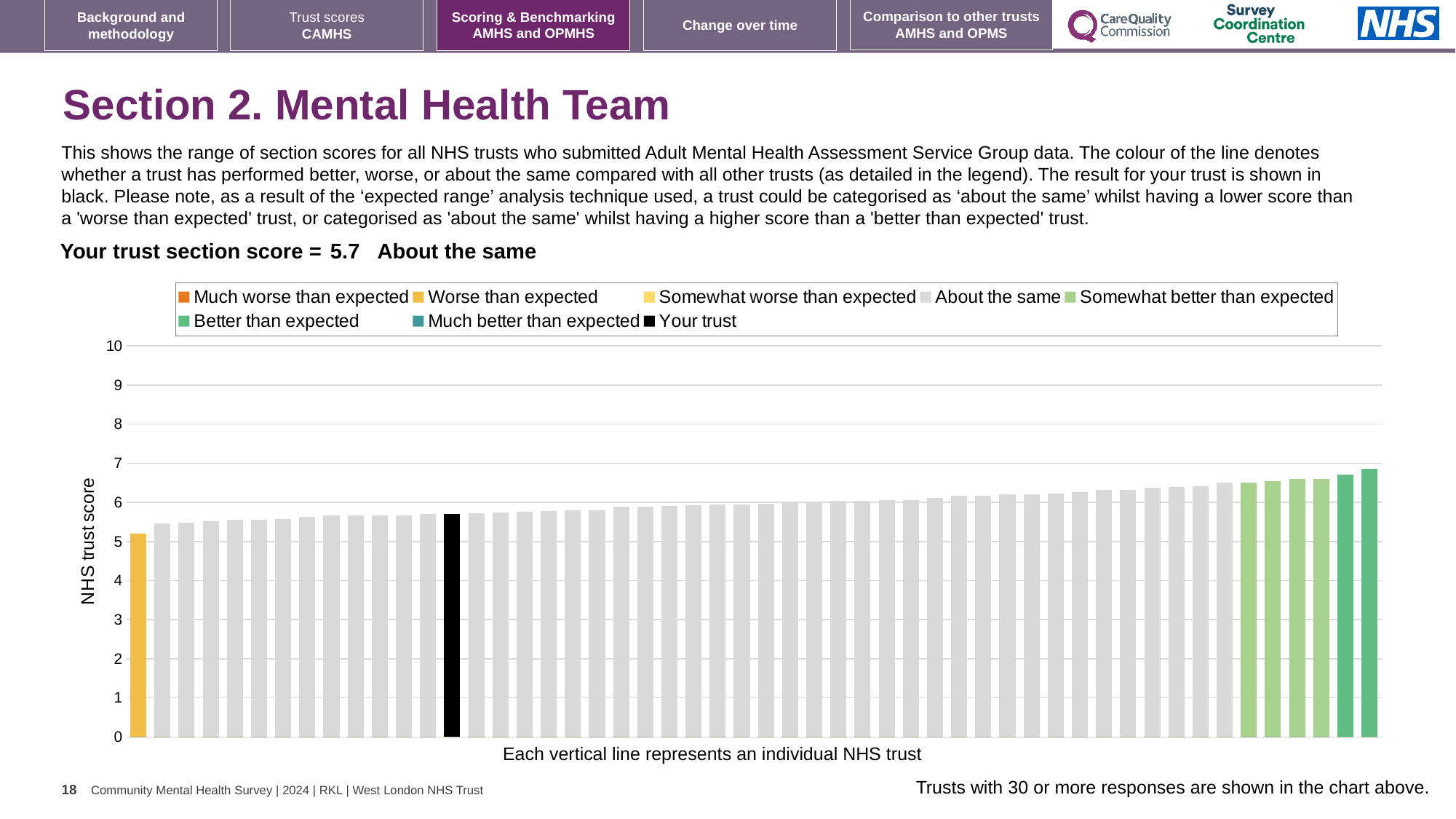
Is the value of the black 'Your trust' bar greater or less than 6? less Is the value of the shortest bar in the chart greater or less than 6? less Is the value of the tallest bar in the chart greater or less than 7? less What is the section score for your trust shown on the slide? 5.7 How many entries does the chart legend list? 8 What is the label on the vertical axis of the chart? NHS trust score What kind of chart is shown on the slide? bar chart According to the legend, which category does the black bar represent? Your trust Which is larger, the leftmost bar or the rightmost bar? the rightmost bar Do the bar values rise or fall from left to right across the chart? rise